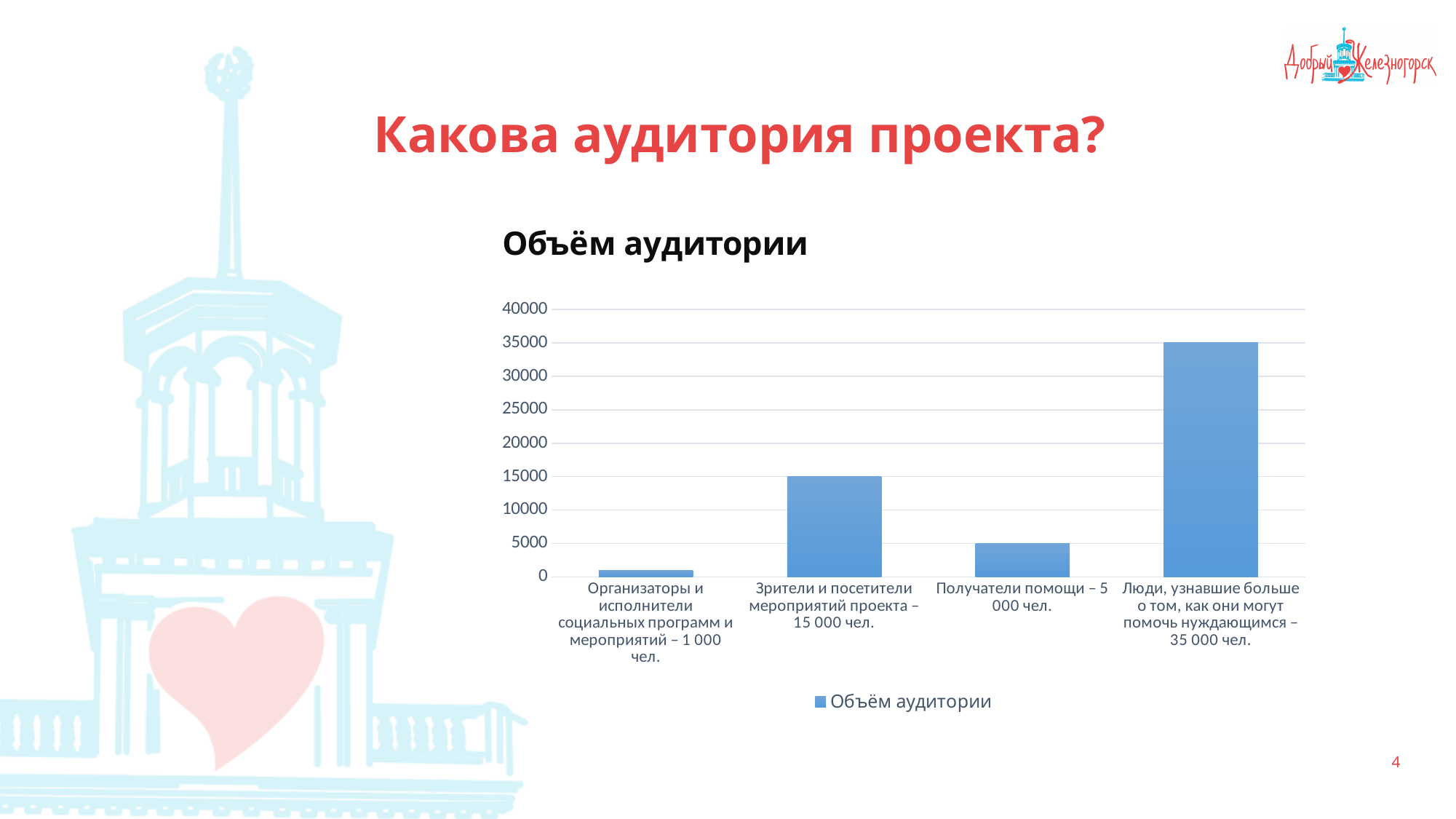
Which is larger: the audience of 'Получатели помощи' or 'Зрители и посетители мероприятий проекта'? Зрители и посетители мероприятий проекта What is the audience size for 'Организаторы и исполнители социальных программ и мероприятий'? 1 000 чел. How many series does the legend list? 1 Which category has the largest audience? Люди, узнавшие больше о том, как они могут помочь нуждающимся Is the value for 'Люди, узнавшие больше о том, как они могут помочь нуждающимся' greater or less than 30000? greater What is the title of the chart? Объём аудитории What is the audience size for 'Получатели помощи'? 5 000 чел. How many categories are shown in the chart? 4 What is the difference between the audience of 'Люди, узнавшие больше о том, как они могут помочь нуждающимся' and 'Зрители и посетители мероприятий проекта'? 20 000 чел. What type of chart is shown on the slide? Bar chart Which category has the smallest audience? Организаторы и исполнители социальных программ и мероприятий What is the audience size for 'Зрители и посетители мероприятий проекта'? 15 000 чел.